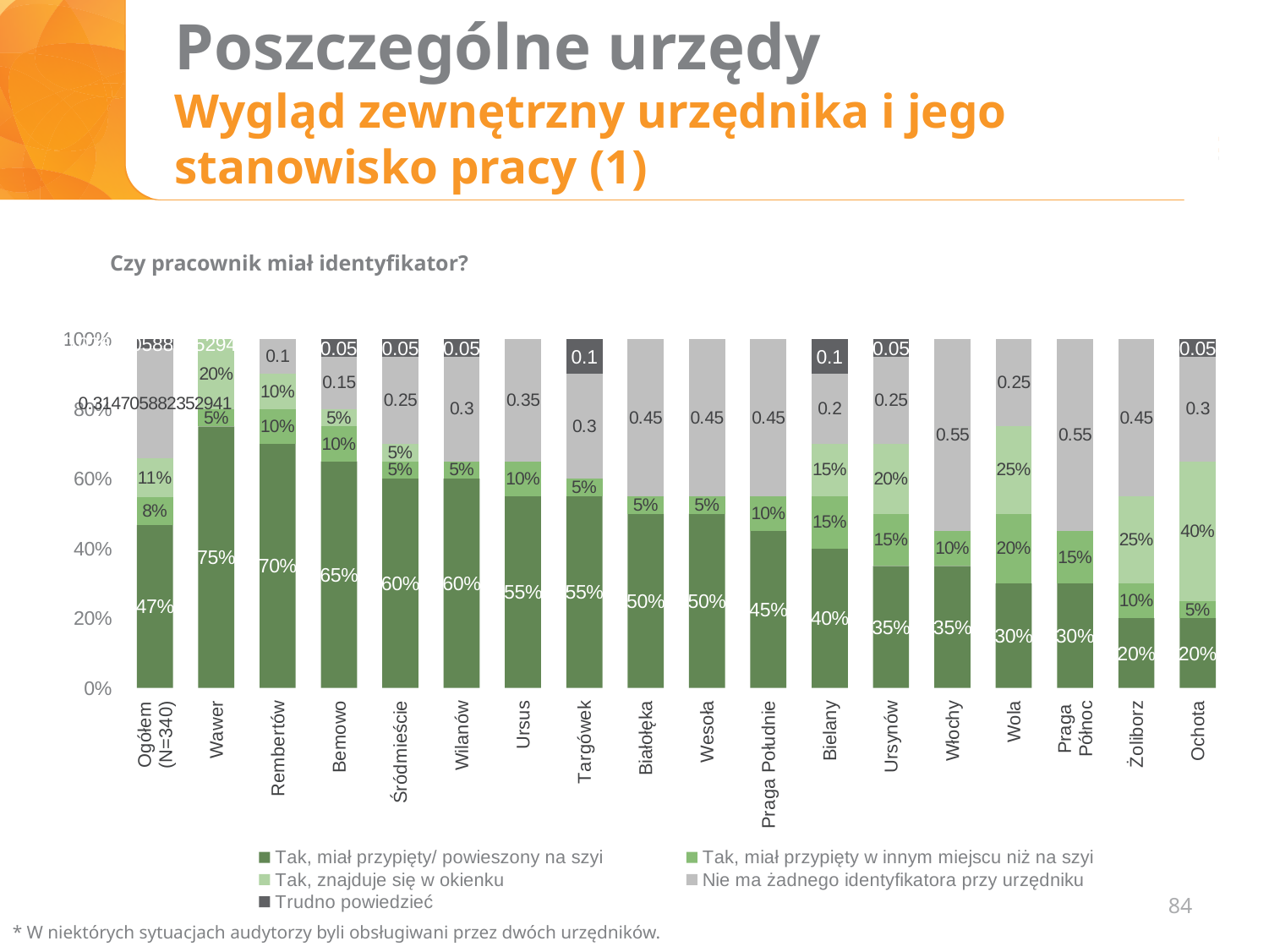
How many categories (offices) are shown on the x axis of the chart? 18 What kind of chart is shown on the slide? Stacked bar chart What is the value of 'Tak, znajduje się w okienku' for Wola? 25% Which has a larger value for 'Tak, miał przypięty/ powieszony na szyi', Rembertów or Bielany? Rembertów What is the value of 'Tak, miał przypięty/ powieszony na szyi' for Ogółem (N=340)? 47% How many series does the chart legend list? 5 Which office has the highest value for 'Tak, miał przypięty/ powieszony na szyi'? Wawer What is the value of 'Tak, miał przypięty/ powieszony na szyi' for Wawer? 75% Which office has the highest value for 'Tak, znajduje się w okienku'? Ochota What is the difference between the 'Tak, miał przypięty/ powieszony na szyi' values for Wawer and Ochota? 55 percentage points What is the value of 'Nie ma żadnego identyfikatora przy urzędniku' for Ursus? 0.35 What question does the chart's title ask? Czy pracownik miał identyfikator?